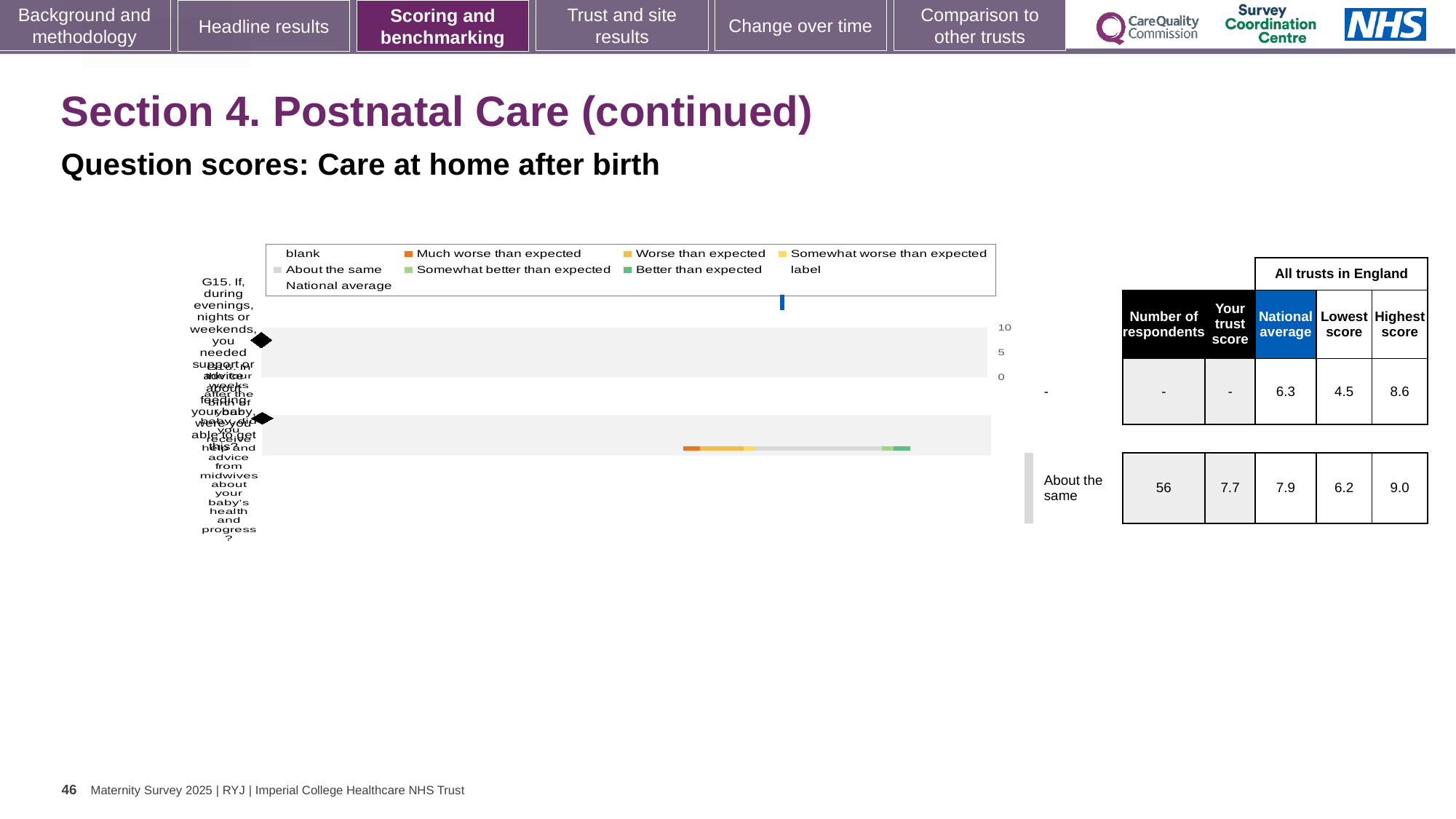
According to the table beside the chart, is the trust's score of 7.7 higher or lower than the national average of 7.9 for the question benchmarked as 'About the same'? lower According to the table beside the chart, what is the lowest score among all trusts in England for the question benchmarked as 'About the same'? 6.2 According to the table beside the chart, what is the difference between the highest score (9.0) and the lowest score (6.2) for the question benchmarked as 'About the same'? 2.8 According to the table beside the chart, what is the trust's score for the question benchmarked as 'About the same'? 7.7 According to the table beside the chart, what is the national average for the question benchmarked as 'About the same'? 7.9 According to the table beside the chart, what is the national average for the first question row, which has no trust score? 6.3 What is the highest value shown on the chart's numeric axis? 10 Which legend entry is shown in orange on the chart? Much worse than expected According to the table beside the chart, how many respondents answered the question benchmarked as 'About the same'? 56 What kind of chart is shown on the slide? bar chart According to the table beside the chart, what is the highest score among all trusts in England for the question benchmarked as 'About the same'? 9.0